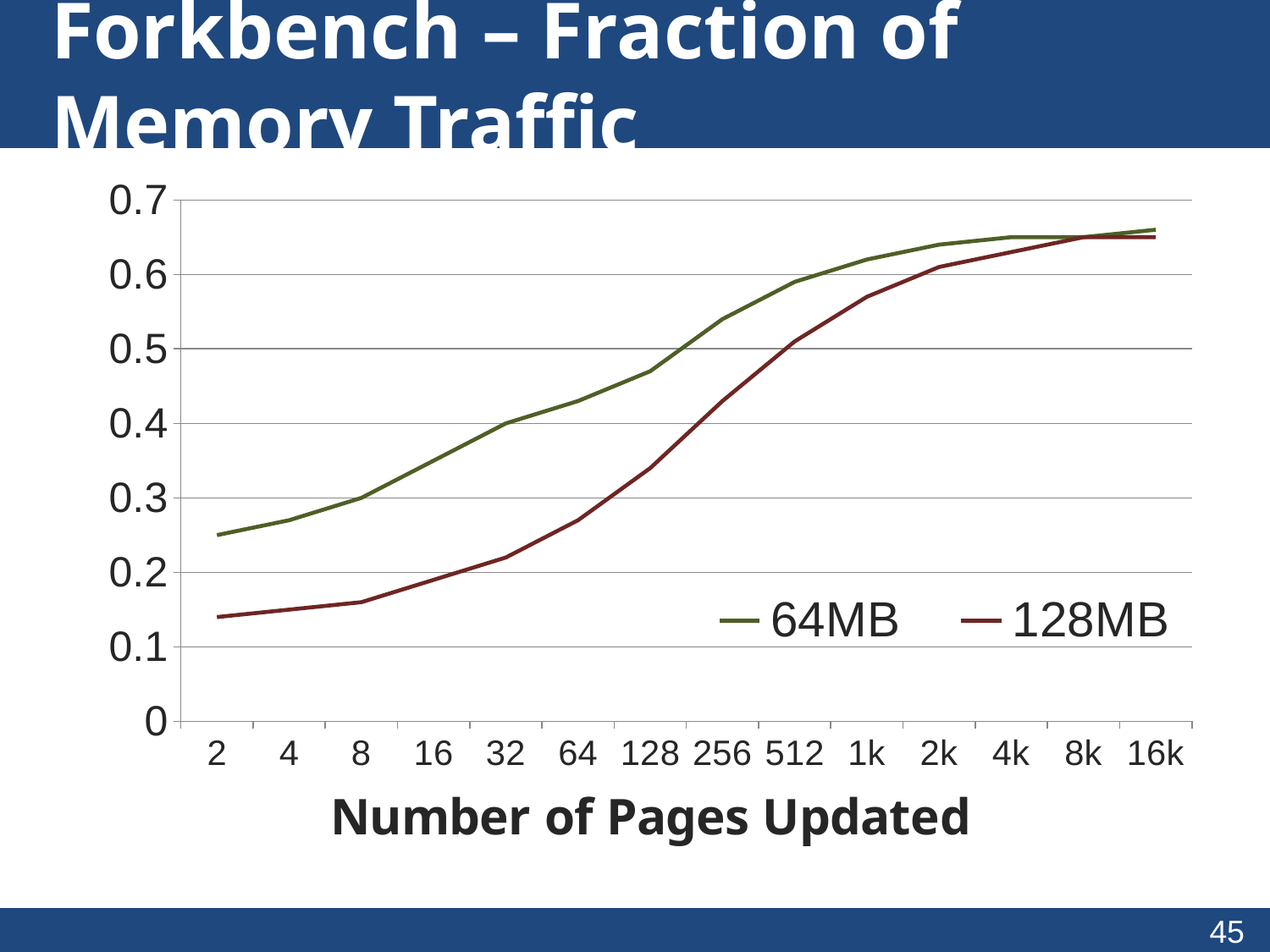
Is the value for 128MB at 2 pages updated greater or less than 0.2? less How many series does the legend list? 2 Do the values for the 128MB series rise or fall as the number of pages updated increases? rise Is the value for 128MB at 16k pages updated greater or less than 0.7? less Is the value for 128MB at 128 pages updated greater or less than 0.4? less How many points are plotted along the x axis for each series? 14 What kind of chart is shown on the slide? line chart What is the title of the x axis? Number of Pages Updated At 128 pages updated, which series has the higher value, 64MB or 128MB? 64MB Do the values for the 64MB series rise or fall as the number of pages updated increases? rise